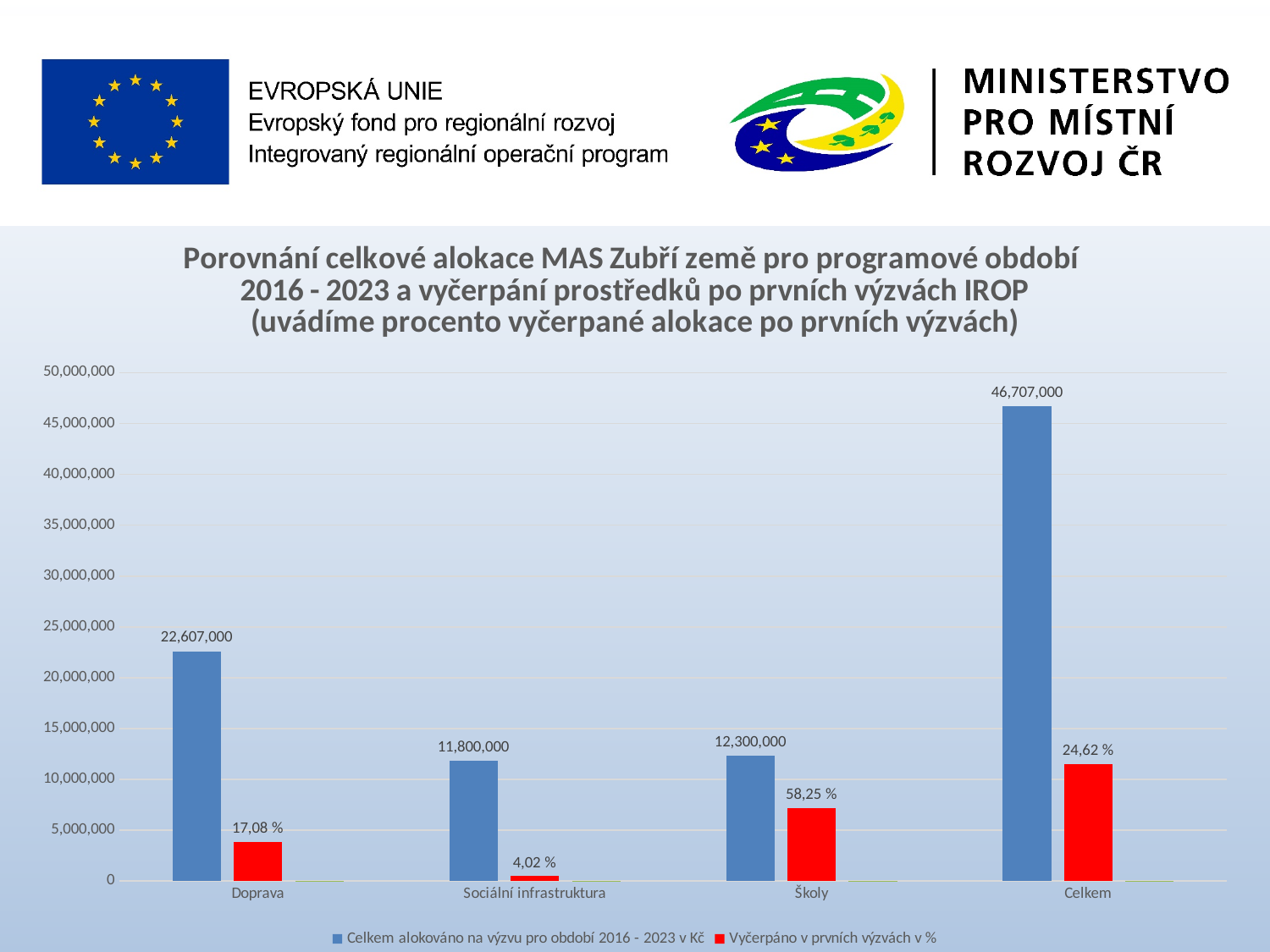
What is the value of the blue bar for Celkem? 46,707,000 How many series does the legend list? 2 What is the difference between the total allocation for Doprava and for Školy? 10,307,000 What is the total allocation (Celkem alokováno) for Doprava? 22,607,000 What percentage was drawn in the first calls for Sociální infrastruktura? 4,02 % What is the total allocation for Sociální infrastruktura? 11,800,000 Which category has the lowest percentage drawn in the first calls? Sociální infrastruktura Which has a larger total allocation, Sociální infrastruktura or Školy? Školy Which category has the highest percentage drawn in the first calls? Školy What percentage was drawn in the first calls (Vyčerpáno v prvních výzvách) for Školy? 58,25 % How many categories are shown on the x axis? 4 What kind of chart is shown on the slide? Bar chart